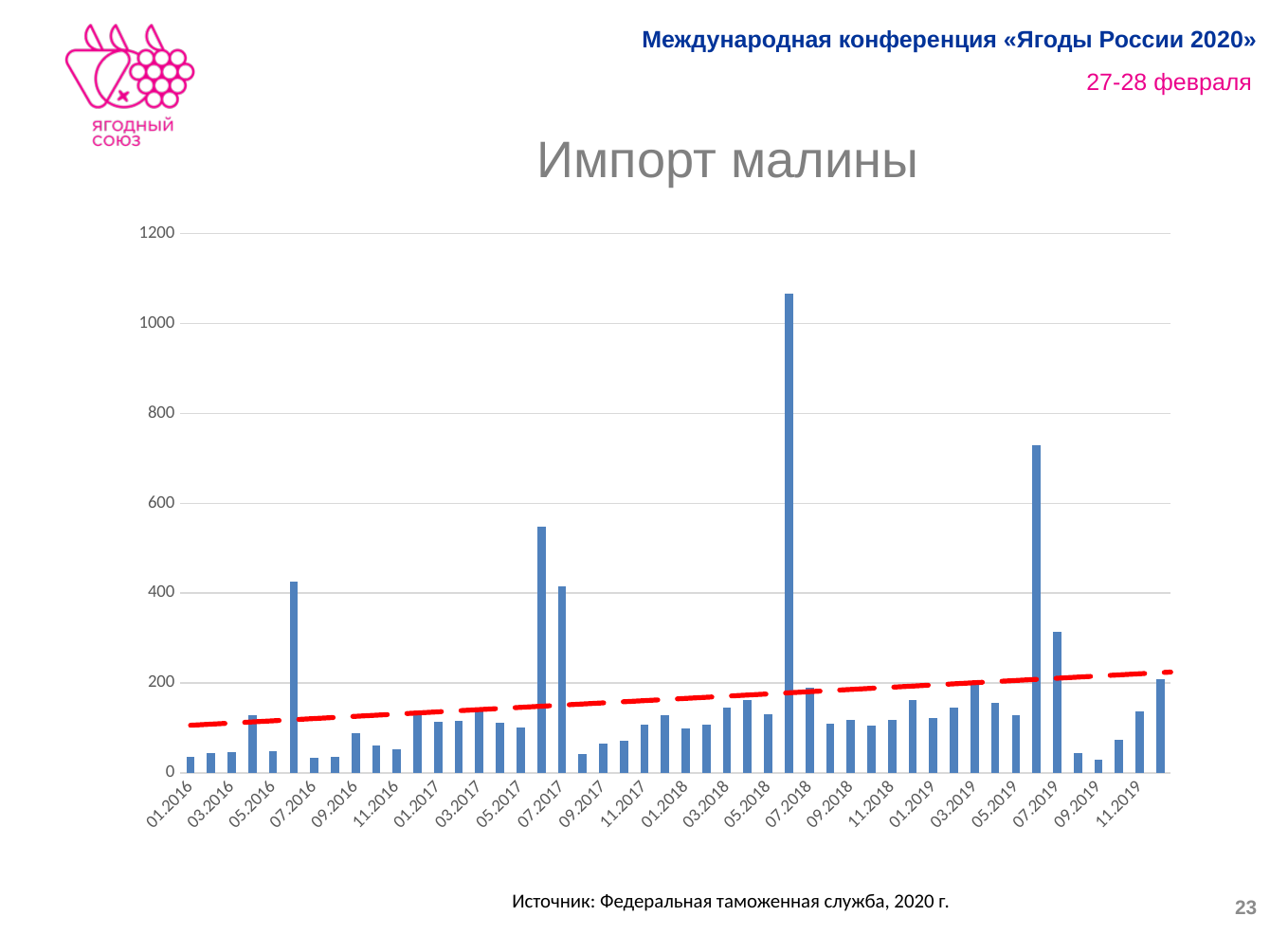
Does the red dashed trend line rise or fall from left to right? rises Which is larger, the value for 01.2016 or the value for 01.2017? 01.2017 Which is larger, the value for 07.2018 or the value for 07.2019? 07.2019 Is the value for 07.2018 greater or less than 1000? less What is the source cited below the chart? Федеральная таможенная служба, 2020 г. Is the value for 01.2016 greater or less than 200? less Is the value for 07.2019 greater or less than 600? less What is the title of the chart? Импорт малины Which month has the highest bar in the chart? 06.2018 What kind of chart is shown on the slide? bar chart